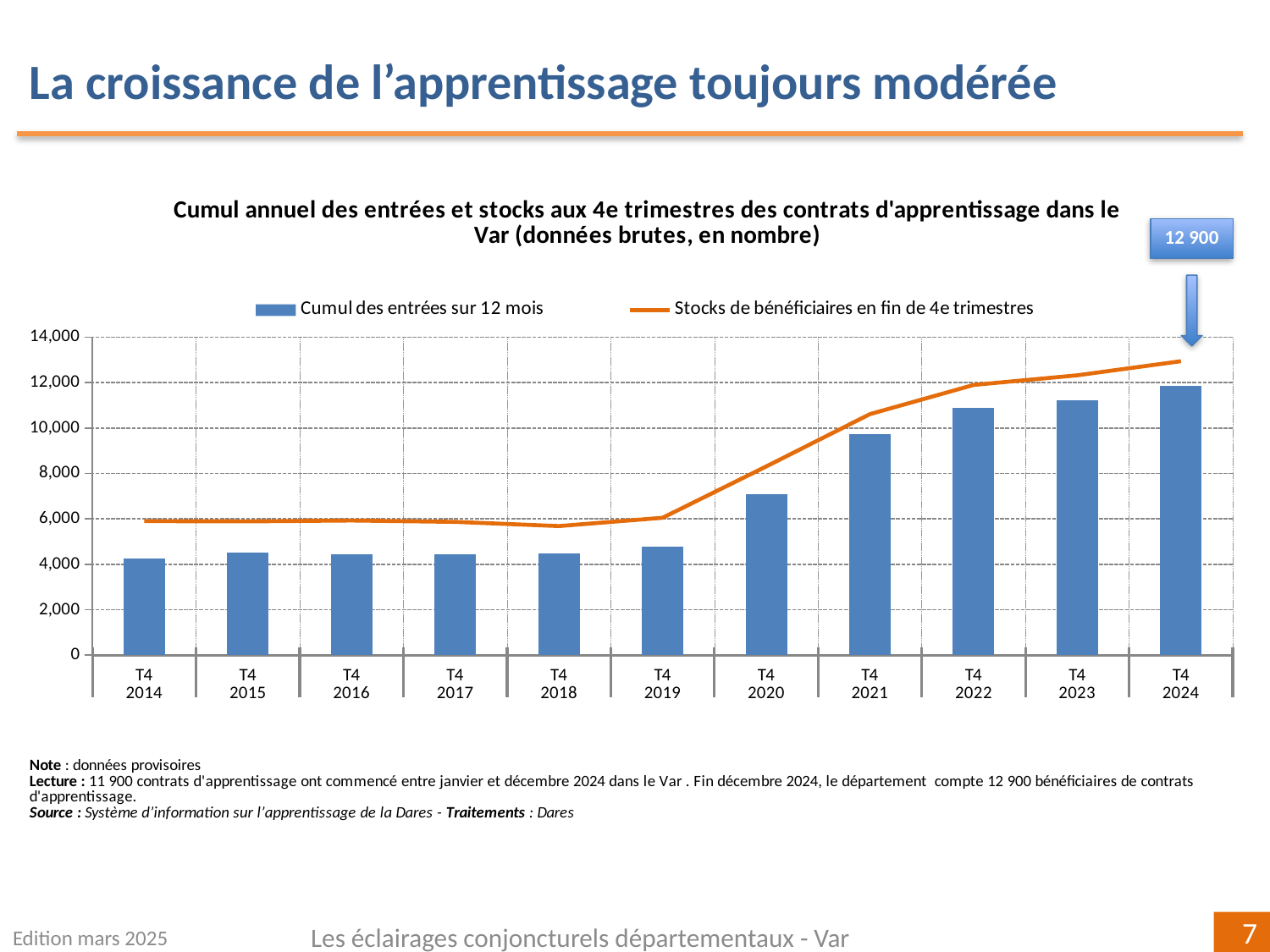
Which is larger, the 'Cumul des entrées sur 12 mois' bar at T4 2019 or at T4 2020? T4 2020 Is the 'Stocks de bénéficiaires' line value at T4 2016 greater or less than 8,000? less Which series is drawn as an orange line? Stocks de bénéficiaires en fin de 4e trimestres Is the bar value for 'Cumul des entrées sur 12 mois' at T4 2021 greater or less than 10,000? less What is the value of 'Stocks de bénéficiaires en fin de 4e trimestres' at T4 2024? 12 900 How many series does the legend list? 2 How many quarters (T4 points) are shown on the x axis? 11 What type of chart is shown on the slide? A combined bar and line chart Do the 'Cumul des entrées sur 12 mois' bars generally rise or fall from T4 2019 to T4 2024? Rise In which quarter is the bar for 'Cumul des entrées sur 12 mois' the highest? T4 2024 In which quarter is the bar for 'Cumul des entrées sur 12 mois' the lowest? T4 2014 Is the bar value for 'Cumul des entrées sur 12 mois' at T4 2020 greater or less than 6,000? greater